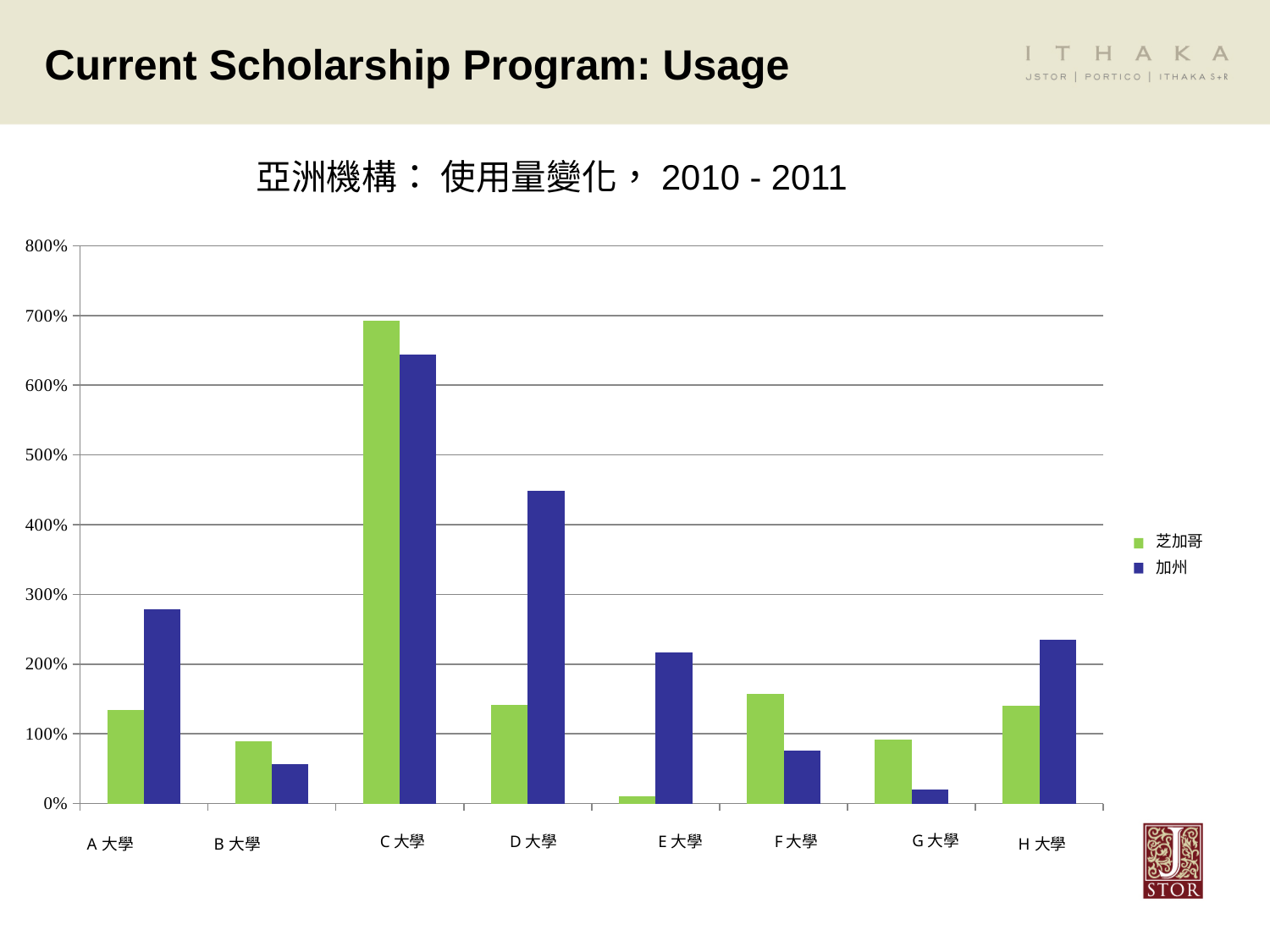
How many universities (categories) are shown on the x axis? 8 What kind of chart is shown on the slide? bar chart Which series is shown in green in the legend? 芝加哥 How many series does the legend list? 2 Is the value for 加州 at C 大學 greater or less than 600%? greater Which university has the highest value for 芝加哥? C 大學 Which university has the lowest value for 芝加哥? E 大學 For F 大學, which series has the larger value, 芝加哥 or 加州? 芝加哥 Which university has the highest value for 加州? C 大學 Which university has the lowest value for 加州? G 大學 For D 大學, which series has the larger value, 芝加哥 or 加州? 加州 Is the value for 芝加哥 at B 大學 greater or less than 100%? less